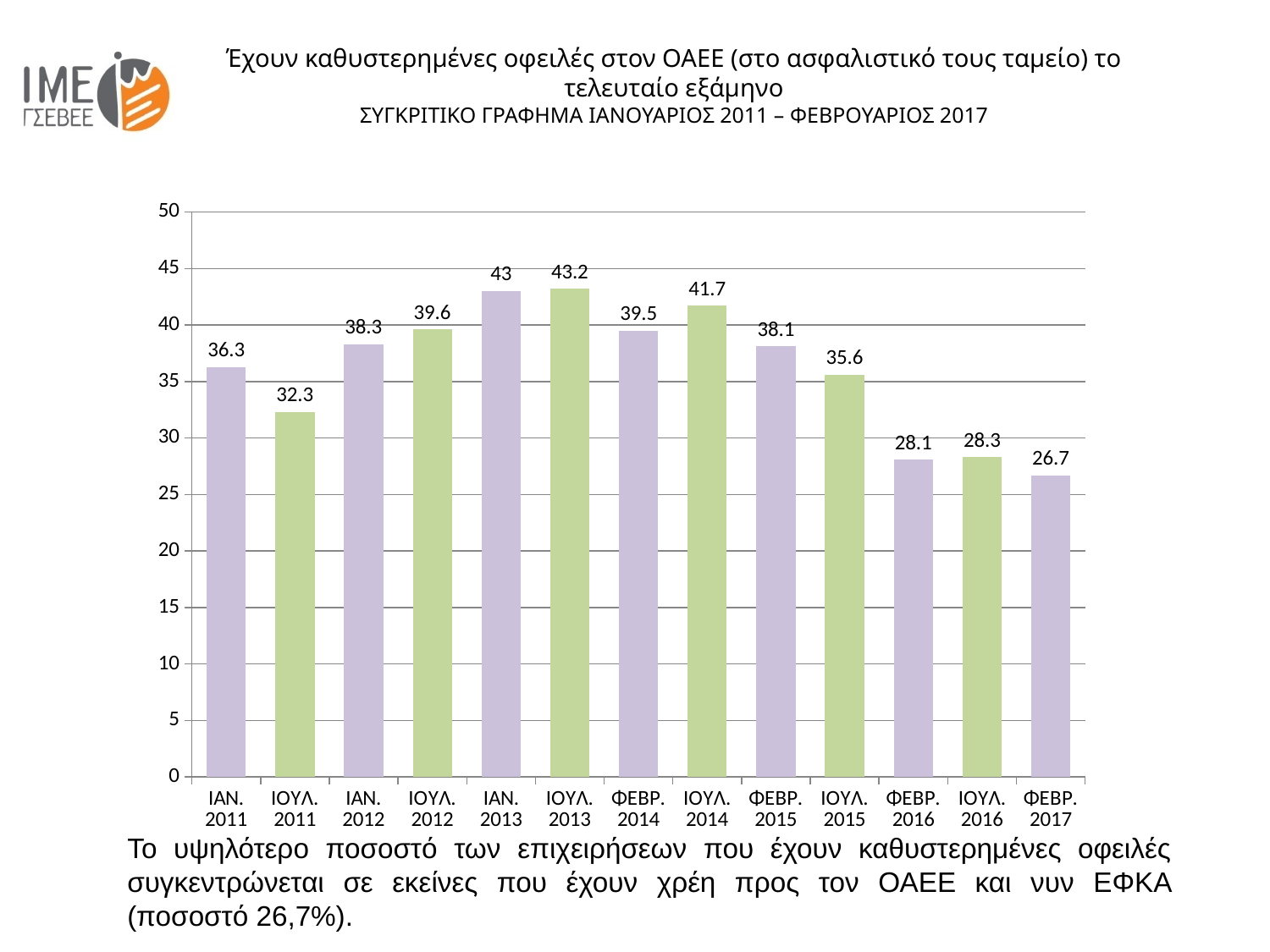
What is the value for ΙΟΥΛ. 2011? 32.3 What is the difference between the values for ΙΟΥΛ. 2013 and ΦΕΒΡ. 2017? 16.5 Which period has the highest value? ΙΟΥΛ. 2013 What is the value for ΙΟΥΛ. 2014? 41.7 What is the value for ΦΕΒΡ. 2017? 26.7 Which is larger, the value for ΦΕΒΡ. 2015 or the value for ΙΟΥΛ. 2015? ΦΕΒΡ. 2015 What is the value for ΙΑΝ. 2011? 36.3 Is the value for ΦΕΒΡ. 2016 greater or less than 30? less How many periods are shown on the x axis? 13 What kind of chart is shown on the slide? bar chart Which period has the lowest value? ΦΕΒΡ. 2017 What is the difference between the values for ΙΑΝ. 2012 and ΙΟΥΛ. 2011? 6